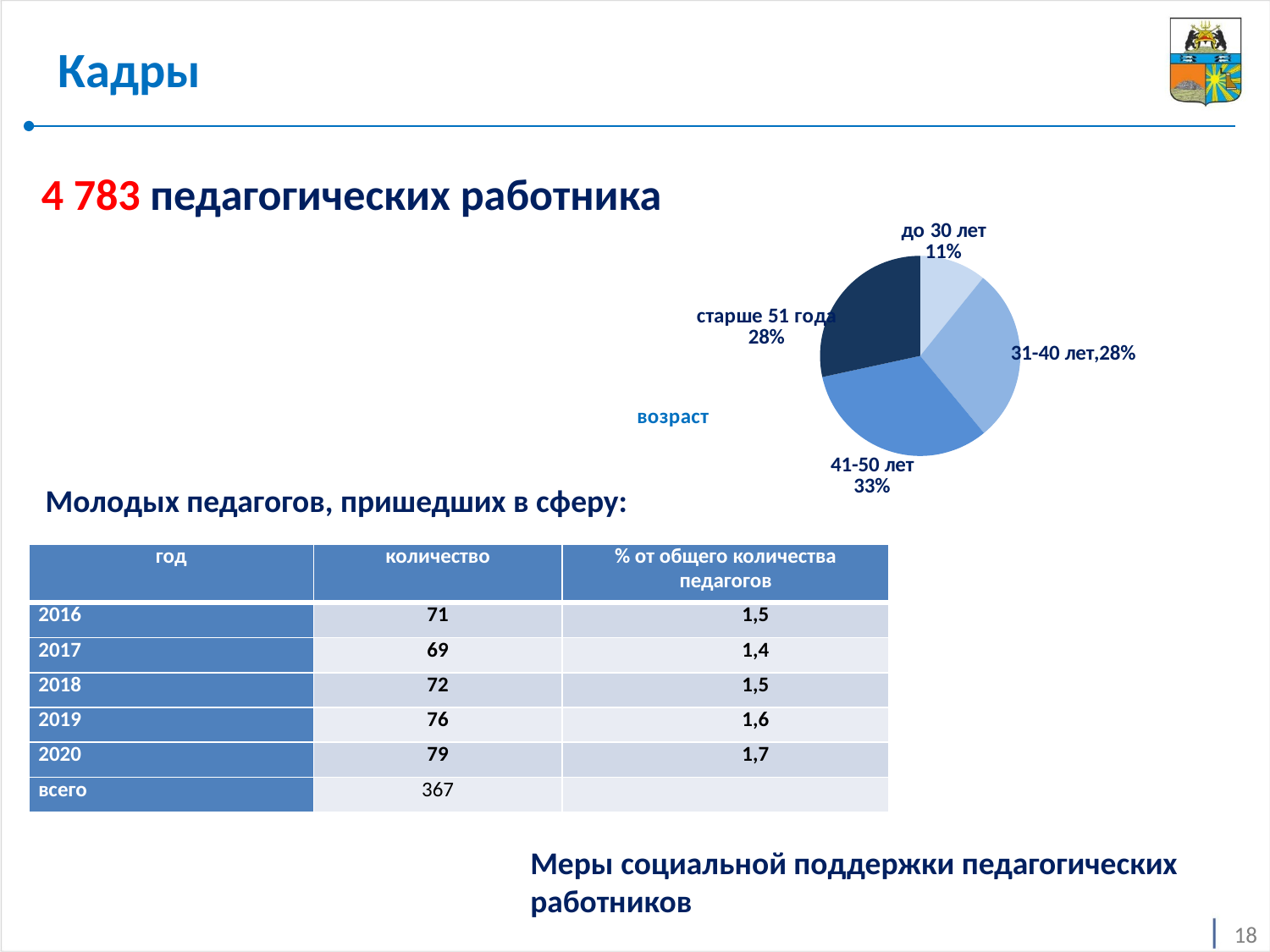
In the pie chart, which slice is larger: '41-50 лет' or '31-40 лет'? 41-50 лет What percentage is shown for the '41-50 лет' slice of the pie chart? 33% What percentage is shown for the '31-40 лет' slice of the pie chart? 28% What type of chart is used to show the age distribution of teachers? Pie chart What is the title of the pie chart? возраст How many slices does the pie chart have? 4 Which age group has the largest slice in the pie chart? 41-50 лет What is the combined share of the '31-40 лет' and 'старше 51 года' slices in the pie chart? 56% By how many percentage points does the '41-50 лет' slice exceed the 'до 30 лет' slice in the pie chart? 22 Which age group has the smallest slice in the pie chart? до 30 лет What share of the pie chart does the 'до 30 лет' slice represent? 11% What percentage is shown for the 'старше 51 года' slice of the pie chart? 28%